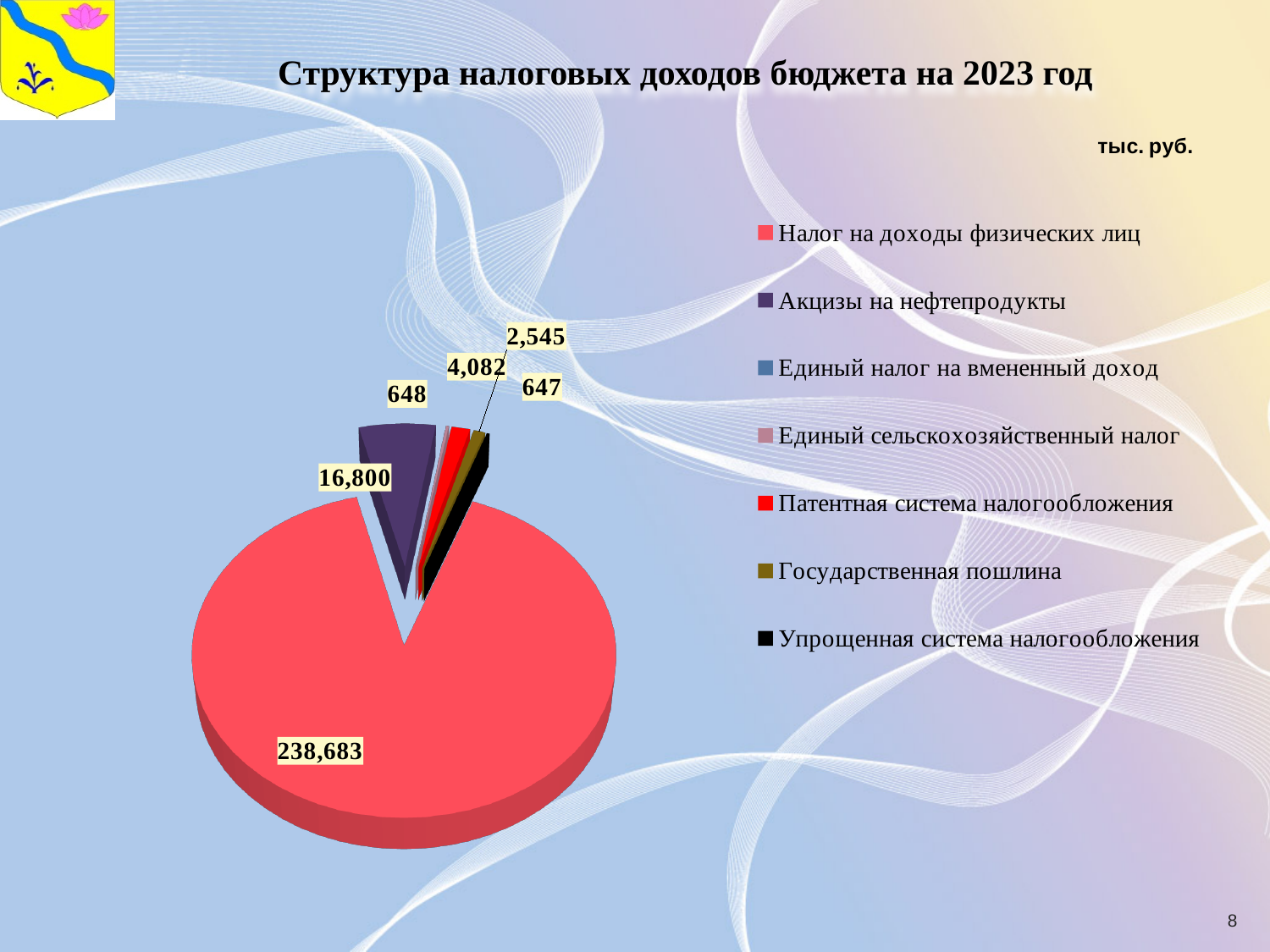
Which category has the largest slice of the pie? Налог на доходы физических лиц In what units are the values on the chart given, according to the slide? тыс. руб. How many data labels are printed on the pie chart? 6 What is the difference between the values for Налог на доходы физических лиц and Акцизы на нефтепродукты? 221,883 What is the title of the chart on the slide? Структура налоговых доходов бюджета на 2023 год What is the value for Акцизы на нефтепродукты? 16,800 Which is larger: Налог на доходы физических лиц or Акцизы на нефтепродукты? Налог на доходы физических лиц What type of chart is shown on the slide? pie chart How many categories does the legend of the pie chart list? 7 What is the value for Налог на доходы физических лиц? 238,683 What is the smallest value printed as a data label on the pie chart? 647